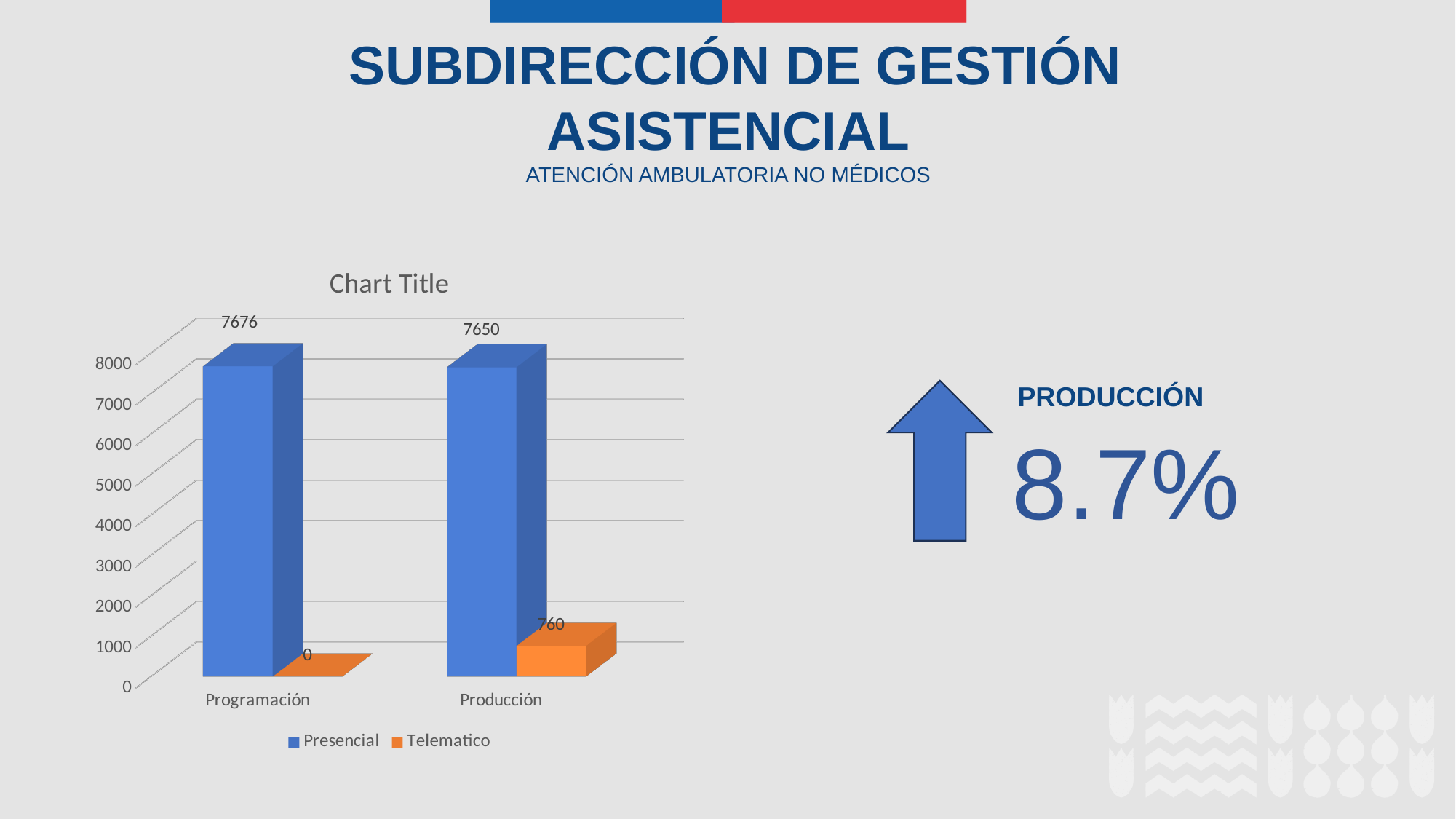
Which series is shown in orange in the legend? Telematico What is the difference between the Presencial values for Programación and Producción? 26 What is the difference between the Presencial and Telematico values for Producción? 6890 How many categories are shown on the x axis? 2 Which category has the higher Telematico value? Producción What kind of chart is shown on the slide? bar chart What is the Telematico value for Producción? 760 How many series does the legend list? 2 What is the Presencial value for Producción? 7650 Is the Presencial value for Producción greater or less than 7000? greater What is the Telematico value for Programación? 0 What is the Presencial value for Programación? 7676